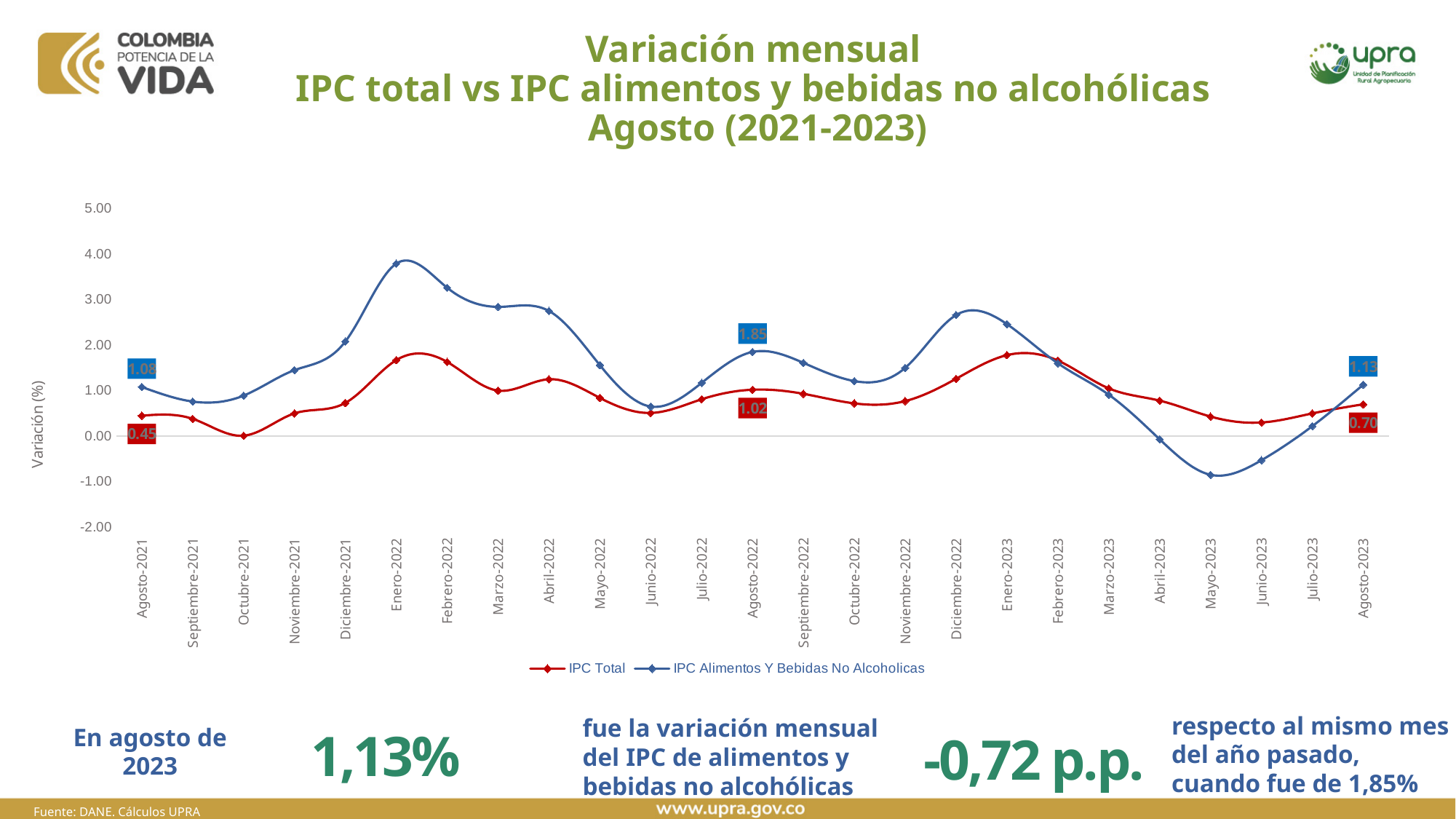
How many series does the legend list? 2 What is the difference between the IPC Alimentos Y Bebidas No Alcoholicas values for Agosto-2022 and Agosto-2023? 0.72 What is the difference between IPC Alimentos Y Bebidas No Alcoholicas and IPC Total in Agosto-2022? 0.83 What is the value of IPC Total for Agosto-2021? 0.45 Which series has the larger value in Agosto-2021, IPC Total or IPC Alimentos Y Bebidas No Alcoholicas? IPC Alimentos Y Bebidas No Alcoholicas In which month does the IPC Alimentos Y Bebidas No Alcoholicas series reach its lowest value? Mayo-2023 What is the value of IPC Alimentos Y Bebidas No Alcoholicas for Agosto-2022? 1.85 In which month does the IPC Alimentos Y Bebidas No Alcoholicas series reach its highest value? Enero-2022 Is the value of IPC Alimentos Y Bebidas No Alcoholicas for Enero-2022 greater or less than 3.00? greater What is the value of IPC Alimentos Y Bebidas No Alcoholicas for Agosto-2023? 1.13 What kind of chart is shown on the slide? Line chart What is the value of IPC Total for Agosto-2022? 1.02